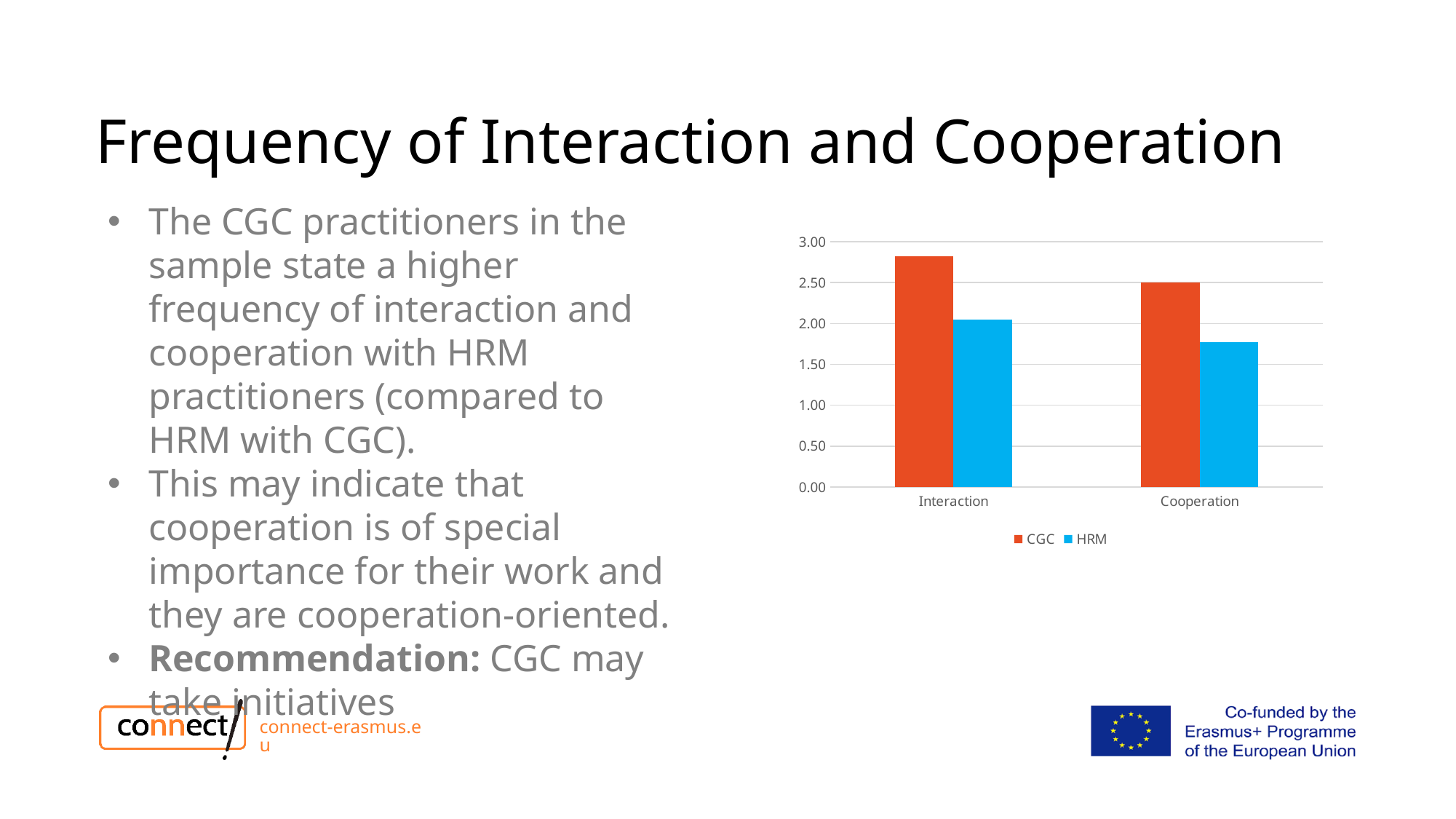
Which bar in the chart is the shortest? HRM for Cooperation Which bar in the chart is the tallest? CGC for Interaction Does the CGC series rise or fall from Interaction to Cooperation? fall Is the HRM value for Cooperation greater or less than 2.00? less How many categories are shown on the x axis of the chart? 2 Is the CGC value for Interaction greater or less than 2.50? greater Which series has the higher value for Interaction, CGC or HRM? CGC Is the CGC value for Cooperation greater or less than 2.00? greater Which series has the higher value for Cooperation, CGC or HRM? CGC Which colour represents the HRM series in the chart? blue What kind of chart is shown on the slide? bar chart How many series does the chart legend list? 2